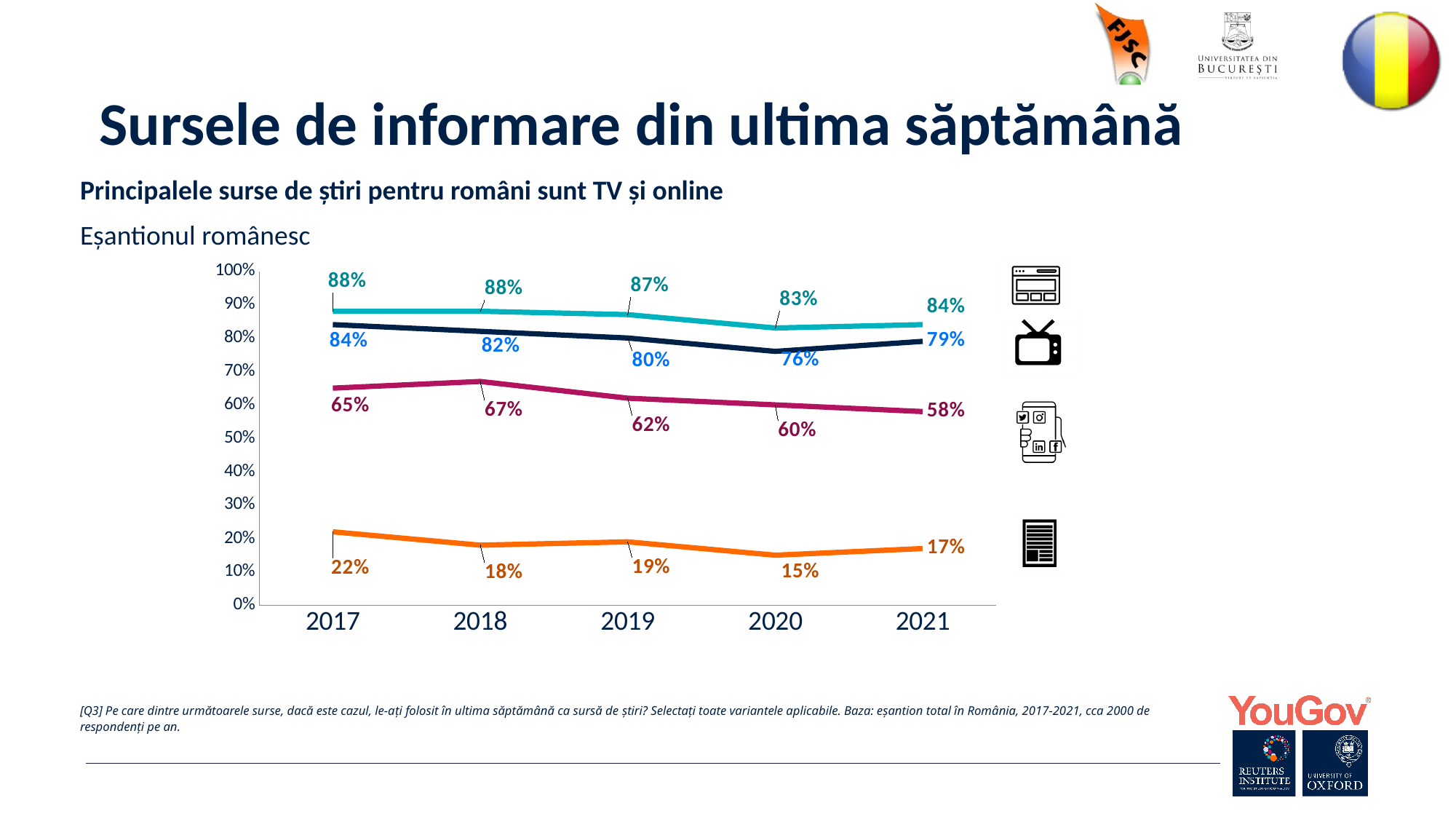
Does the teal (top) line rise or fall from 2017 to 2021? fall In which year does the magenta line reach its highest value? 2018 What is the value of the magenta line in 2018? 67% What kind of chart is shown on the slide? line chart What is the value of the orange (bottom) line in 2021? 17% In which year does the orange (bottom) line reach its lowest value? 2020 What is the difference between the teal line and the dark navy line in 2021? 5% How many lines (series) are plotted on the chart? 4 How many years are shown on the x axis of the chart? 5 Which is larger in 2019: the magenta line or the orange line? the magenta line What is the value of the top teal line in 2017? 88% What is the value of the dark navy line in 2020? 76%